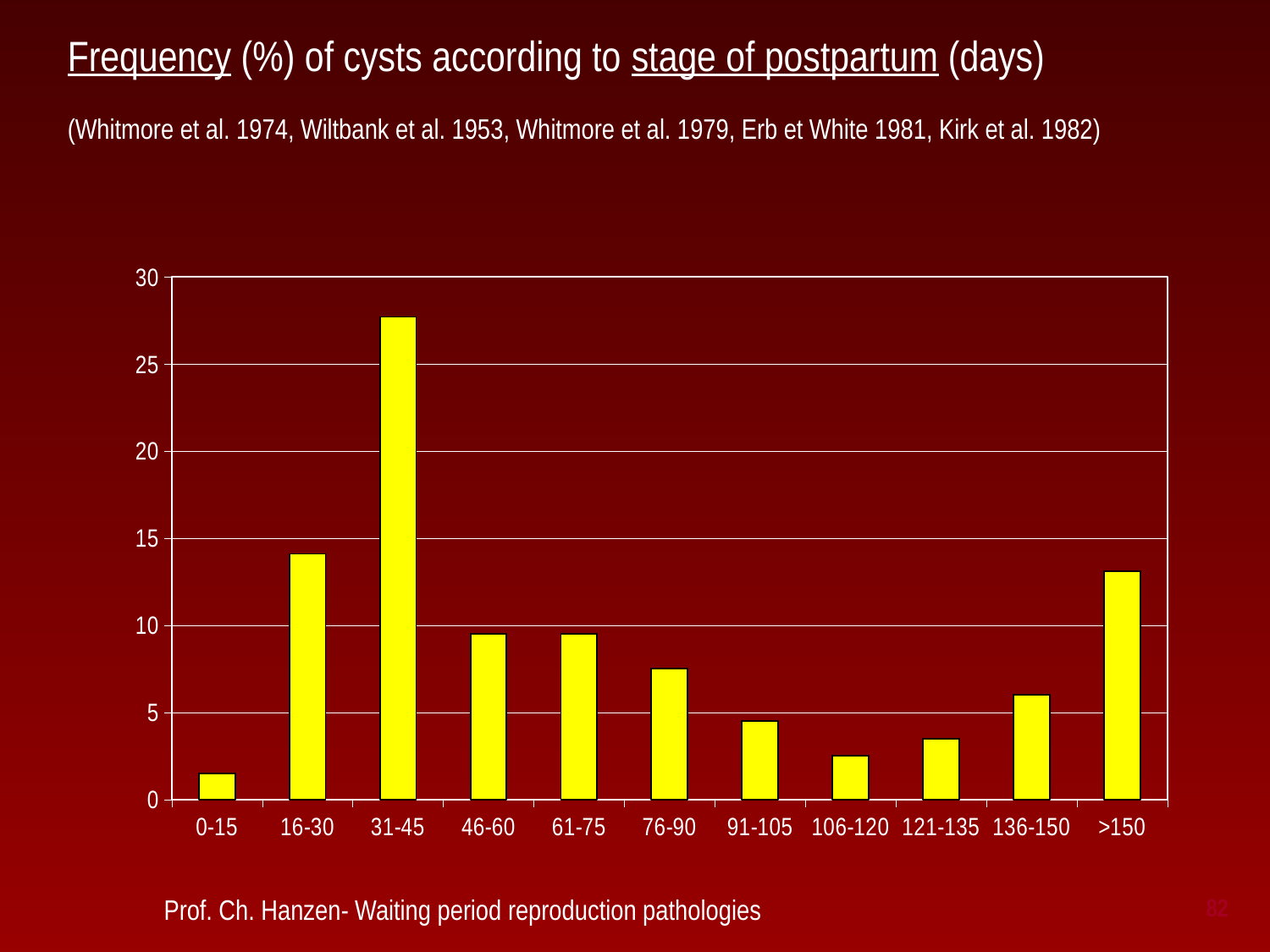
Is the value for >150 greater or less than 10? greater Is the value for 16-30 greater or less than 15? less Which postpartum stage has the lowest frequency of cysts? 0-15 How many postpartum stage categories are shown on the x axis? 11 Is the value for 0-15 greater or less than 5? less Which has a higher frequency, 136-150 or 121-135? 136-150 What kind of chart is shown on the slide? bar chart Which has a higher frequency, 16-30 or 46-60? 16-30 Which postpartum stage has the highest frequency of cysts? 31-45 What colour are the bars in the chart? yellow